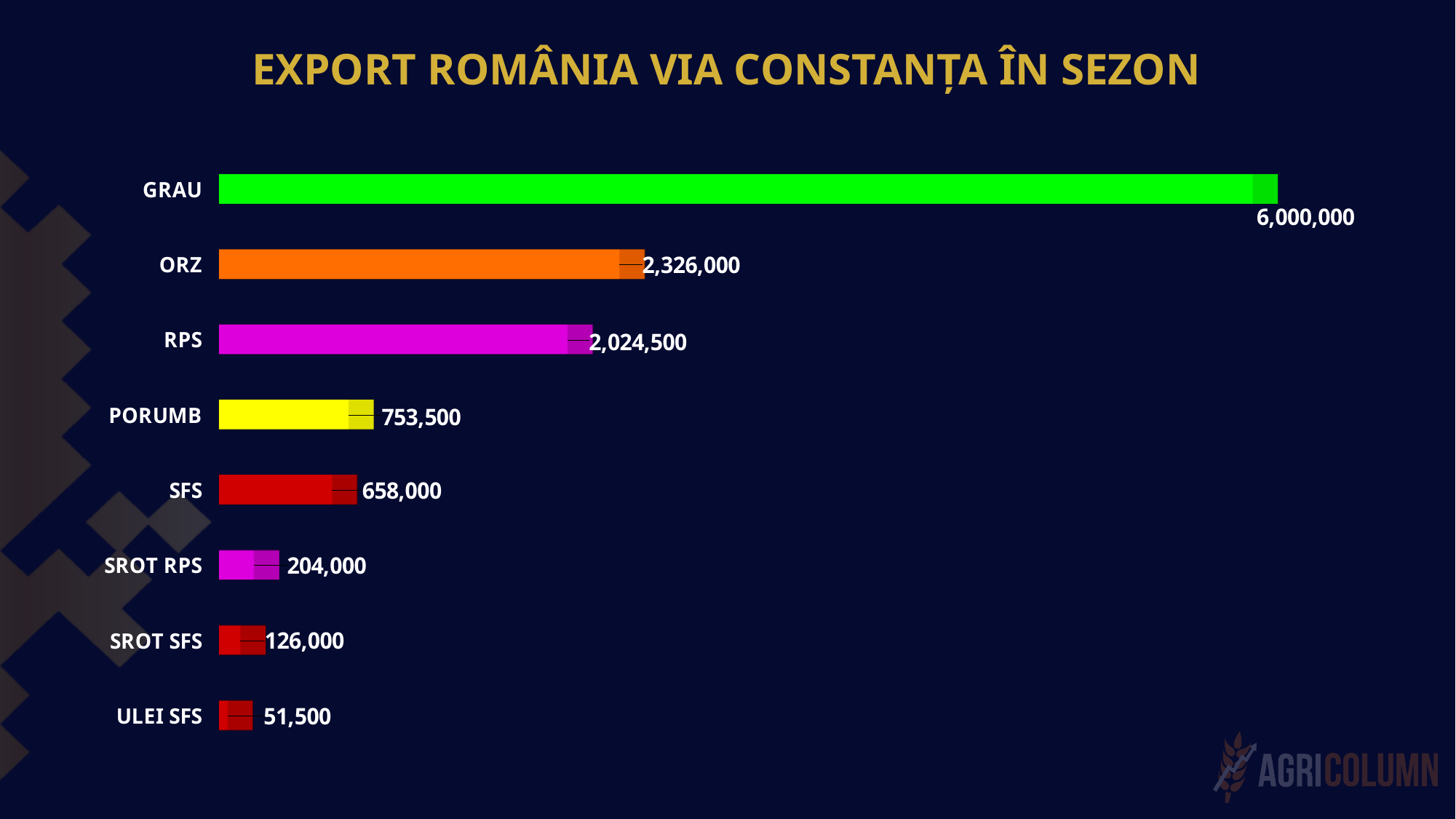
What is the difference between the values for ORZ and RPS? 301,500 What is the value for GRAU? 6,000,000 What is the value for SROT SFS? 126,000 What is the value for ORZ? 2,326,000 What is the value for PORUMB? 753,500 What is the difference between the values for PORUMB and SFS? 95,500 What kind of chart is shown on the slide? Bar chart Which is larger, the value for SROT RPS or the value for SROT SFS? SROT RPS What is the title of the chart? EXPORT ROMÂNIA VIA CONSTANȚA ÎN SEZON Which category has the lowest value? ULEI SFS How many categories are shown in the chart? 8 Which category has the highest value? GRAU